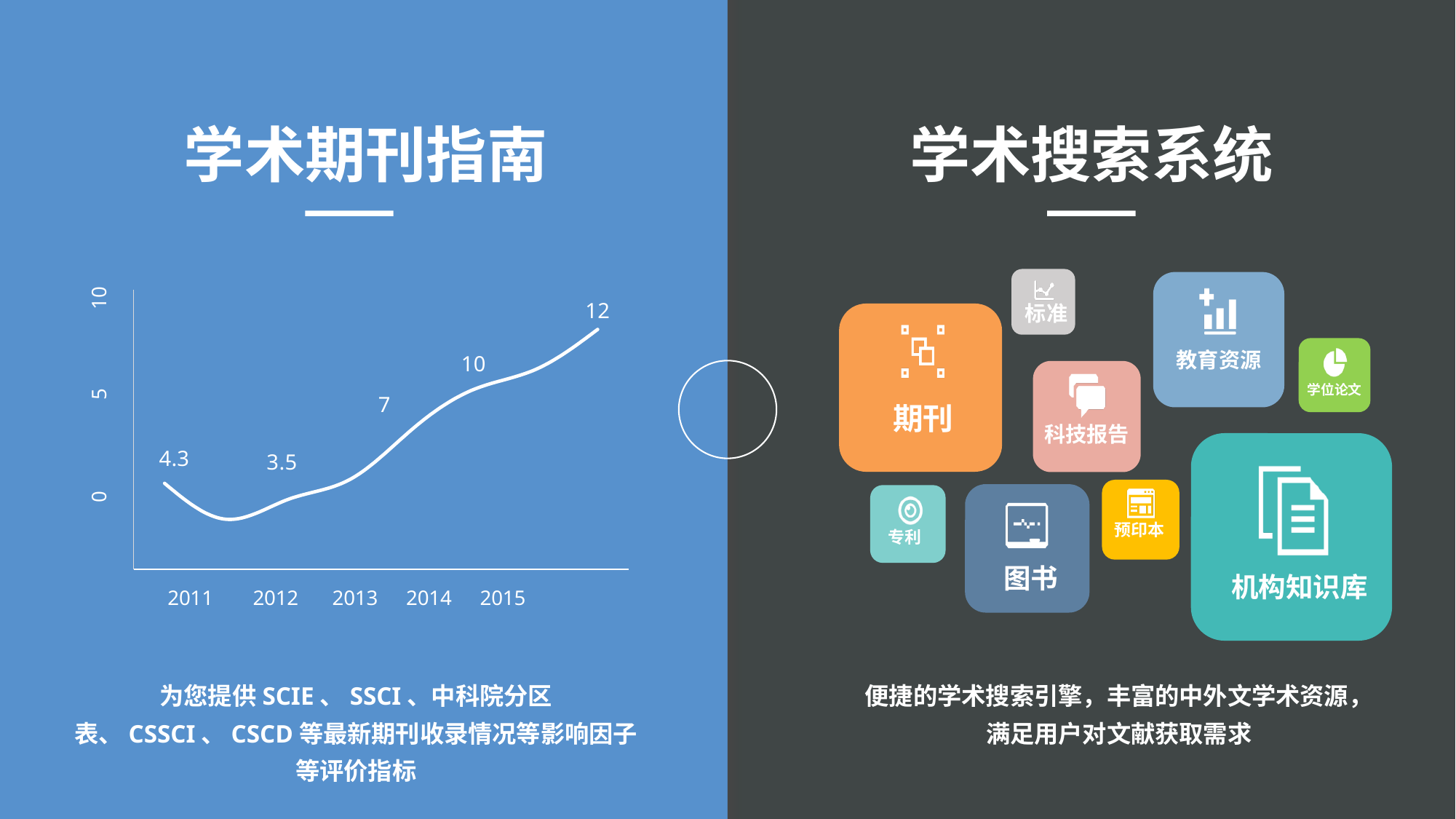
From 2012 to 2015, do the values in the line chart rise or fall? rise Which year has the larger value in the line chart, 2011 or 2013? 2013 What type of chart is shown on the left side of the slide? line chart What is the value for 2013 in the line chart? 7